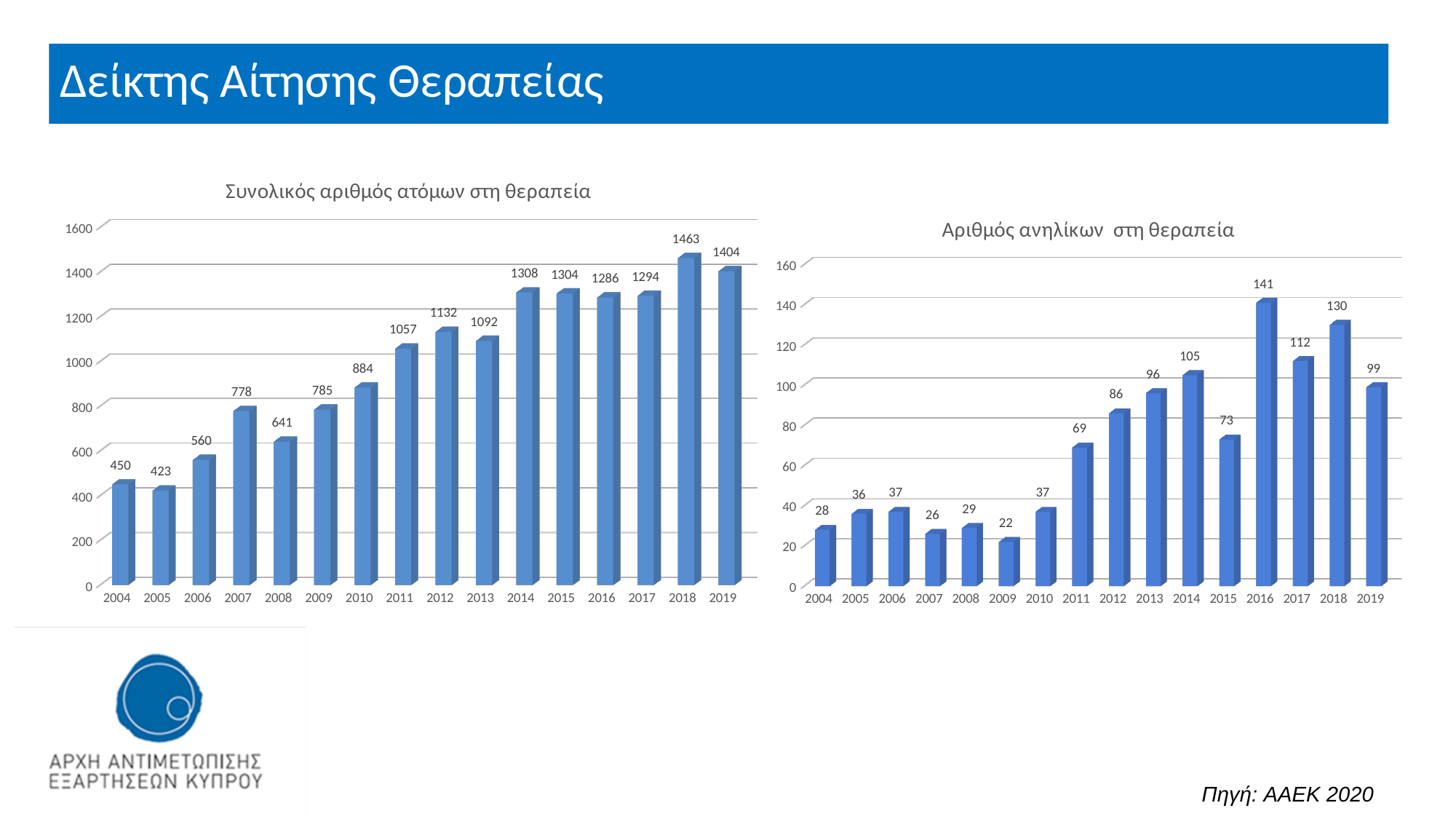
What type of chart is the right chart 'Αριθμός ανηλίκων στη θεραπεία'? bar chart In the right chart 'Αριθμός ανηλίκων στη θεραπεία', which year has the lowest value? 2009 In the right chart 'Αριθμός ανηλίκων στη θεραπεία', what is the value for 2014? 105 In the left chart 'Συνολικός αριθμός ατόμων στη θεραπεία', which year has the lowest value? 2005 In the left chart 'Συνολικός αριθμός ατόμων στη θεραπεία', which year has the highest value? 2018 In the left chart 'Συνολικός αριθμός ατόμων στη θεραπεία', what is the difference between the values for 2018 and 2019? 59 In the left chart 'Συνολικός αριθμός ατόμων στη θεραπεία', how many years are shown on the x axis? 16 In the right chart 'Αριθμός ανηλίκων στη θεραπεία', what is the difference between the values for 2016 and 2015? 68 In the left chart 'Συνολικός αριθμός ατόμων στη θεραπεία', is the value for 2007 greater or less than 800? less In the right chart 'Αριθμός ανηλίκων στη θεραπεία', which is larger, the value for 2017 or the value for 2019? 2017 In the right chart 'Αριθμός ανηλίκων στη θεραπεία', which year has the highest value? 2016 In the left chart 'Συνολικός αριθμός ατόμων στη θεραπεία', what is the value for 2010? 884